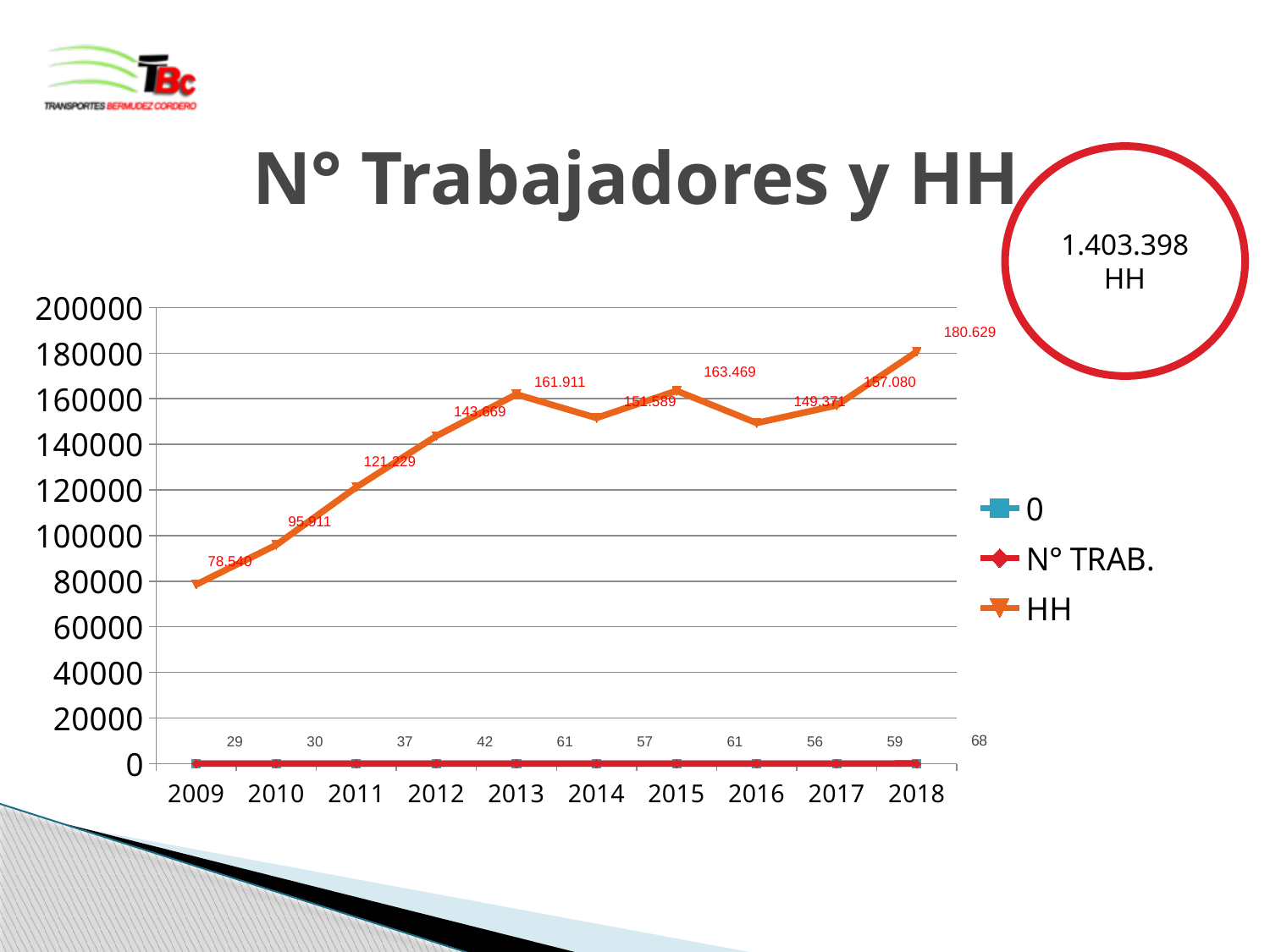
What is the N° TRAB. value for 2018? 68 What is the N° TRAB. value for 2012? 42 What is the HH value for 2009? 78.540 By how much does N° TRAB. in 2018 exceed N° TRAB. in 2009? 39 Which year has the larger HH value, 2013 or 2015? 2015 How many series does the legend list? 3 In which year is the HH value highest? 2018 Is the HH value for 2011 greater or less than 140000? less How many years are shown on the x axis? 10 What kind of chart is shown on the slide? line chart In which year is the N° TRAB. value lowest? 2009 What is the HH value for 2018? 180.629